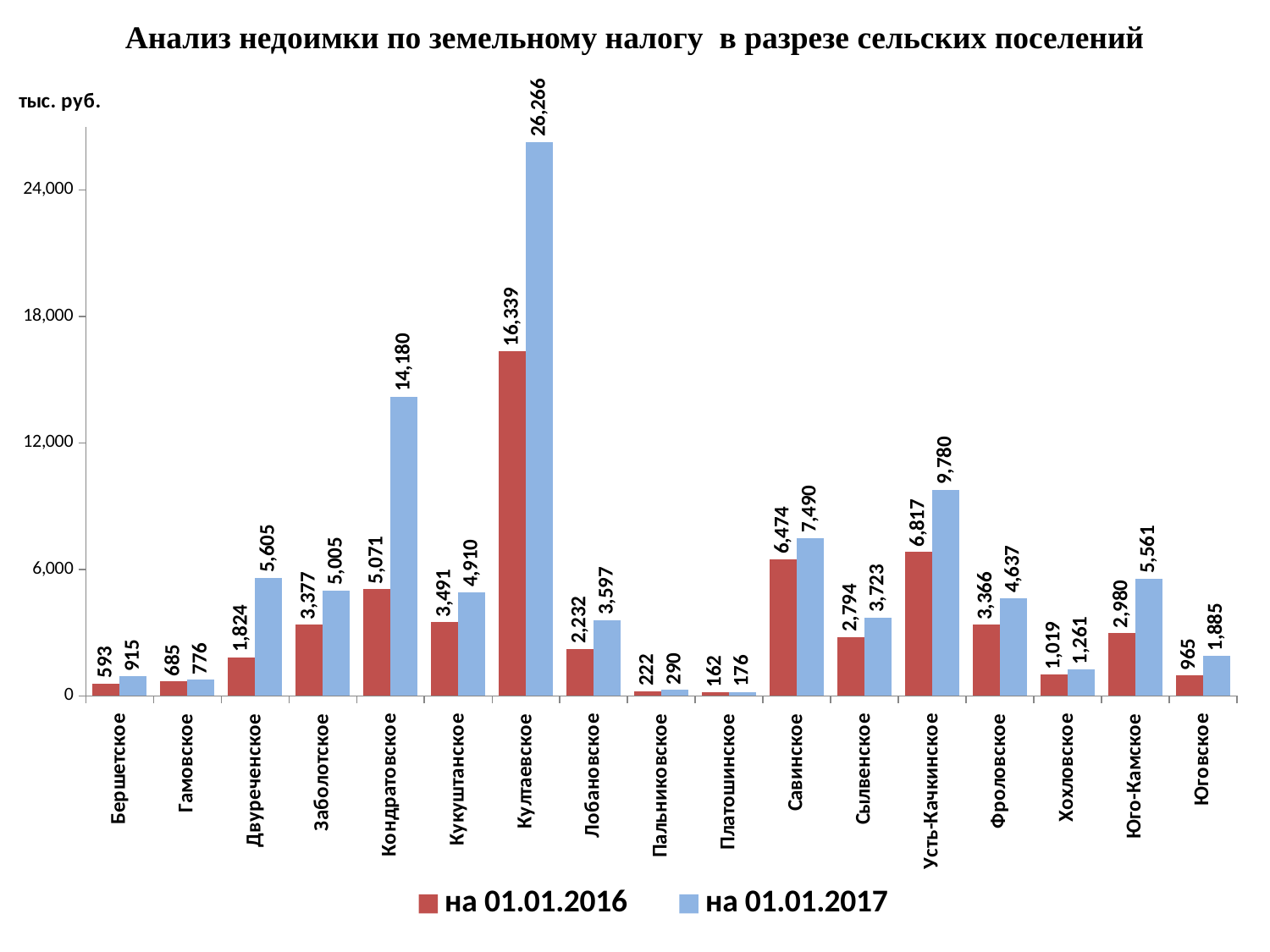
How many series does the legend list? 2 What is the value for Кондратовское on 01.01.2016? 5,071 What kind of chart is shown on the slide? bar chart Which settlement has the highest value on 01.01.2017? Култаевское What is the difference between the 01.01.2017 and 01.01.2016 values for Двуреченское? 3,781 Which settlement has the lowest value on 01.01.2016? Платошинское What is the value for Юго-Камское on 01.01.2017? 5,561 By how much did the value for Кондратовское increase from 01.01.2016 to 01.01.2017? 9,109 What is the value for Култаевское on 01.01.2017? 26,266 Is the value for Култаевское on 01.01.2016 greater or less than 12,000? greater Which is larger on 01.01.2017: Савинское or Усть-Качкинское? Усть-Качкинское How many settlements are shown on the x axis? 17